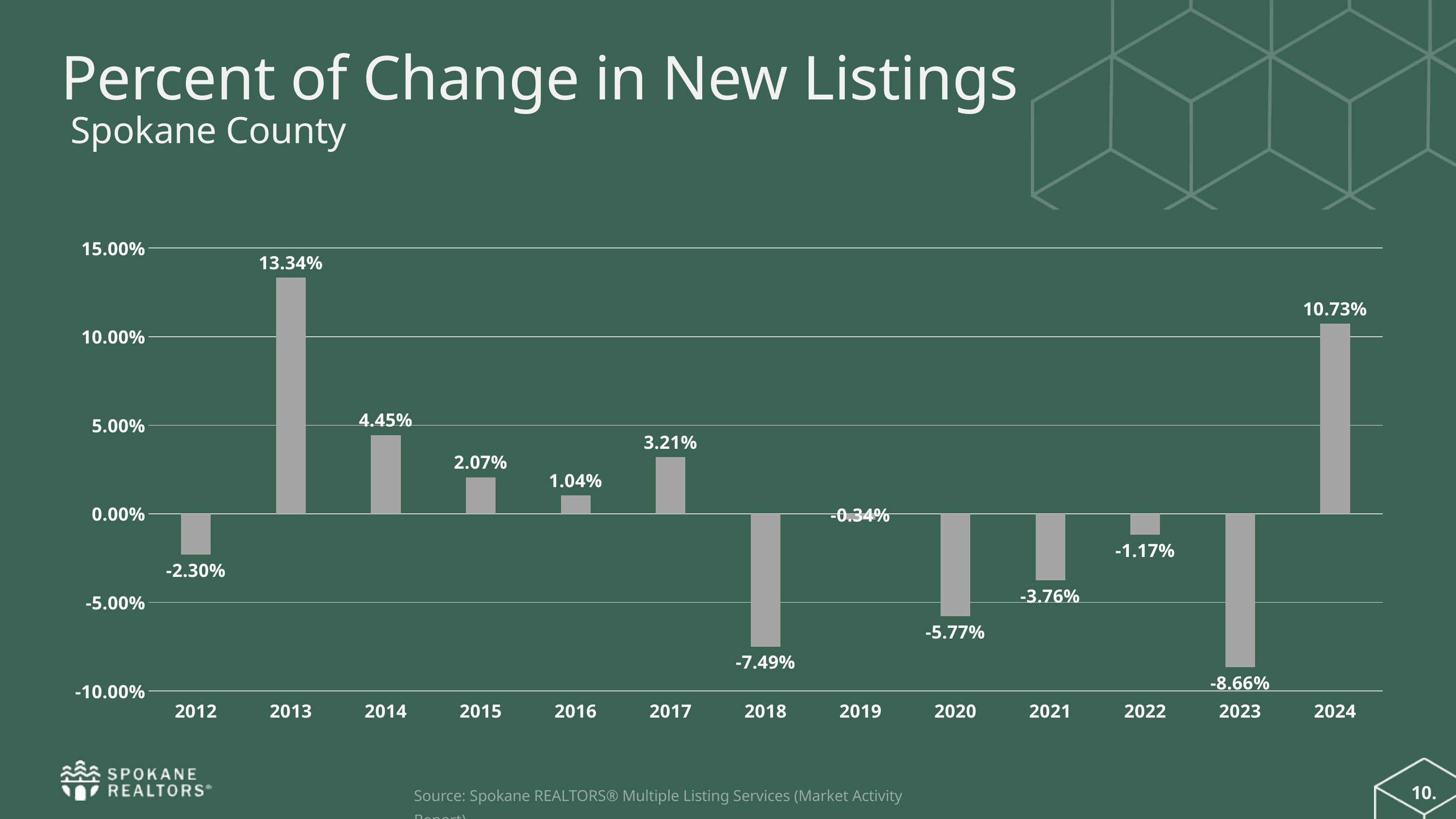
How many years are shown on the x axis of the chart? 13 What is the percent of change in new listings for 2024? 10.73% What is the percent of change in new listings for 2019? -0.34% What is the difference between the values for 2013 and 2024? 2.61 percentage points What kind of chart is shown on the slide? Bar chart What is the percent of change in new listings for 2013? 13.34% Which year has the highest percent of change in new listings? 2013 Which year has the lowest percent of change in new listings? 2023 What is the percent of change in new listings for 2023? -8.66% Which year has the larger percent of change in new listings, 2014 or 2017? 2014 Is the value for 2024 greater or less than 10.00%? greater Do the values rise or fall from 2013 to 2016? Fall